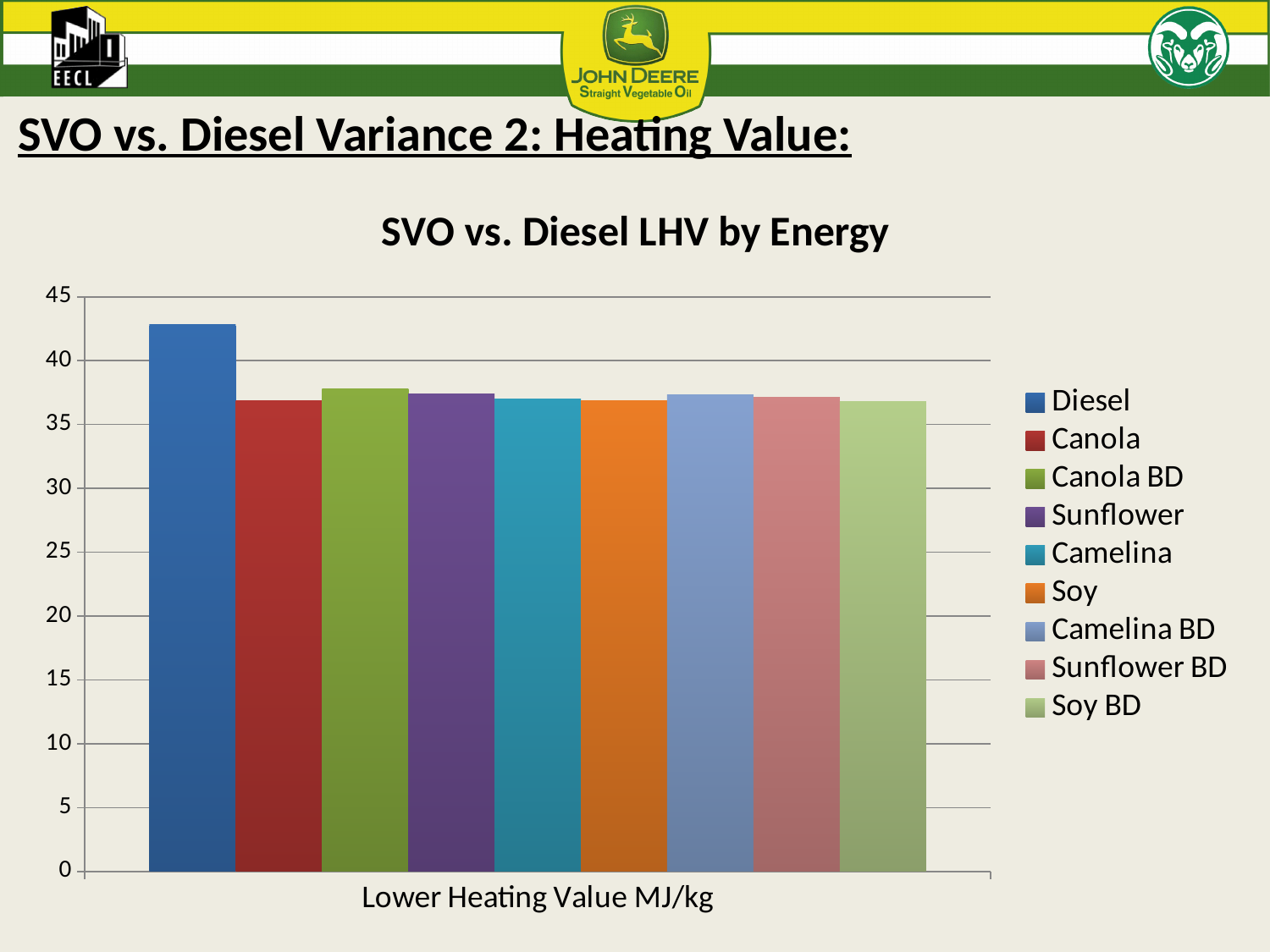
Which has a larger value, Soy BD or Diesel? Diesel How many bars are plotted in the chart? 9 Is the value for Soy BD greater or less than 35? greater What is the label shown on the horizontal axis of the chart? Lower Heating Value MJ/kg Is the value for Canola BD greater or less than 35? greater Is the value for Canola greater or less than 40? less Which fuel has the highest Lower Heating Value in the chart? Diesel How many series does the legend list? 9 What is the title of the chart? SVO vs. Diesel LHV by Energy Which has a larger value, Diesel or Canola? Diesel What type of chart is shown on the slide? bar chart